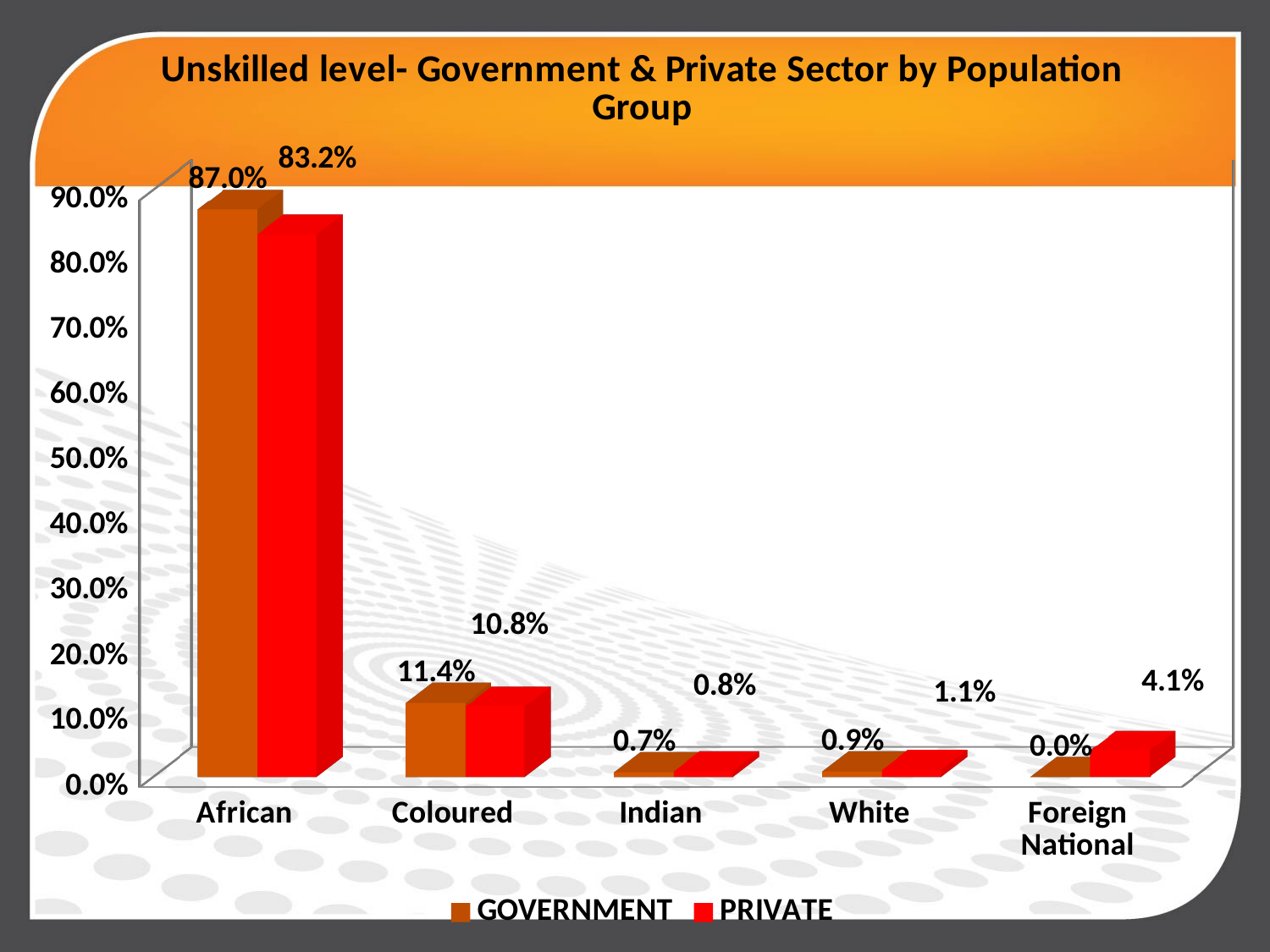
How many population groups are shown on the x axis? 5 What is the PRIVATE value for White? 1.1% What kind of chart is shown on the slide? bar chart What is the GOVERNMENT value for African? 87.0% What is the PRIVATE value for Coloured? 10.8% What is the GOVERNMENT value for Foreign National? 0.0% For Foreign National, which is larger: the GOVERNMENT value or the PRIVATE value? PRIVATE Is the PRIVATE value for African greater or less than 80.0%? greater Which population group has the lowest PRIVATE value? Indian What is the difference between the GOVERNMENT and PRIVATE values for African? 3.8% Which population group has the highest GOVERNMENT value? African How many series does the legend list? 2